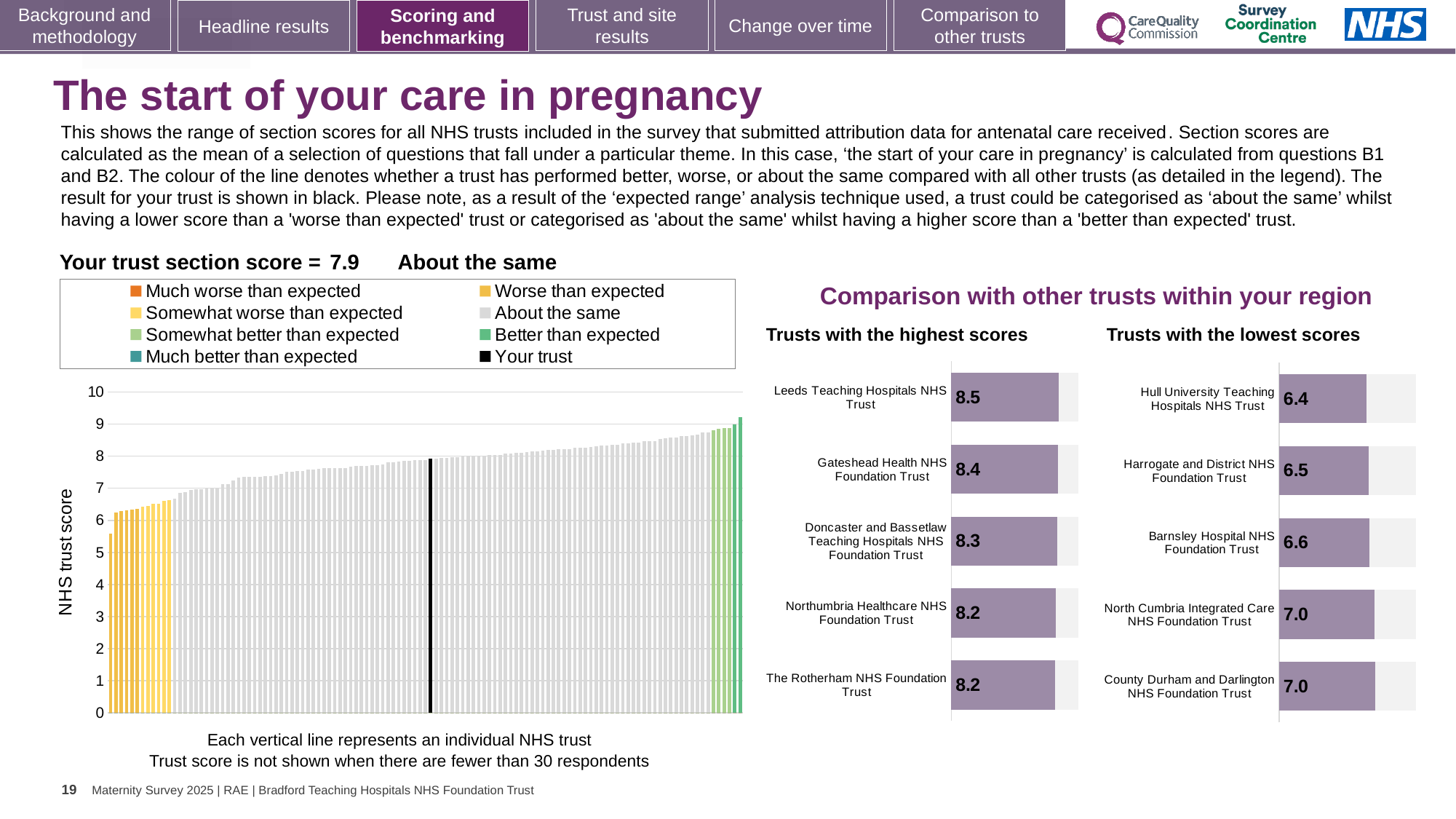
On the main 'NHS trust score' chart on the left, what is the section score for your trust? 7.9 On the 'Trusts with the lowest scores' chart, which trust has the lowest score? Hull University Teaching Hospitals NHS Trust On the 'Trusts with the lowest scores' chart, which has the higher score: Barnsley Hospital NHS Foundation Trust or Harrogate and District NHS Foundation Trust? Barnsley Hospital NHS Foundation Trust On the 'Trusts with the highest scores' chart, what is the score for Leeds Teaching Hospitals NHS Trust? 8.5 How many trusts are shown on the 'Trusts with the lowest scores' chart? 5 On the 'Trusts with the highest scores' chart, what is the difference between the scores of Leeds Teaching Hospitals NHS Trust and Northumbria Healthcare NHS Foundation Trust? 0.3 On the main 'NHS trust score' chart on the left, do the trust scores rise or fall from left to right? rise On the 'Trusts with the lowest scores' chart, what is the difference between the scores of County Durham and Darlington NHS Foundation Trust and Hull University Teaching Hospitals NHS Trust? 0.6 On the 'Trusts with the highest scores' chart, what is the score for Doncaster and Bassetlaw Teaching Hospitals NHS Foundation Trust? 8.3 On the 'Trusts with the lowest scores' chart, what is the score for Hull University Teaching Hospitals NHS Trust? 6.4 How many entries does the legend of the main 'NHS trust score' chart on the left list? 8 On the 'Trusts with the highest scores' chart, which trust has the highest score? Leeds Teaching Hospitals NHS Trust